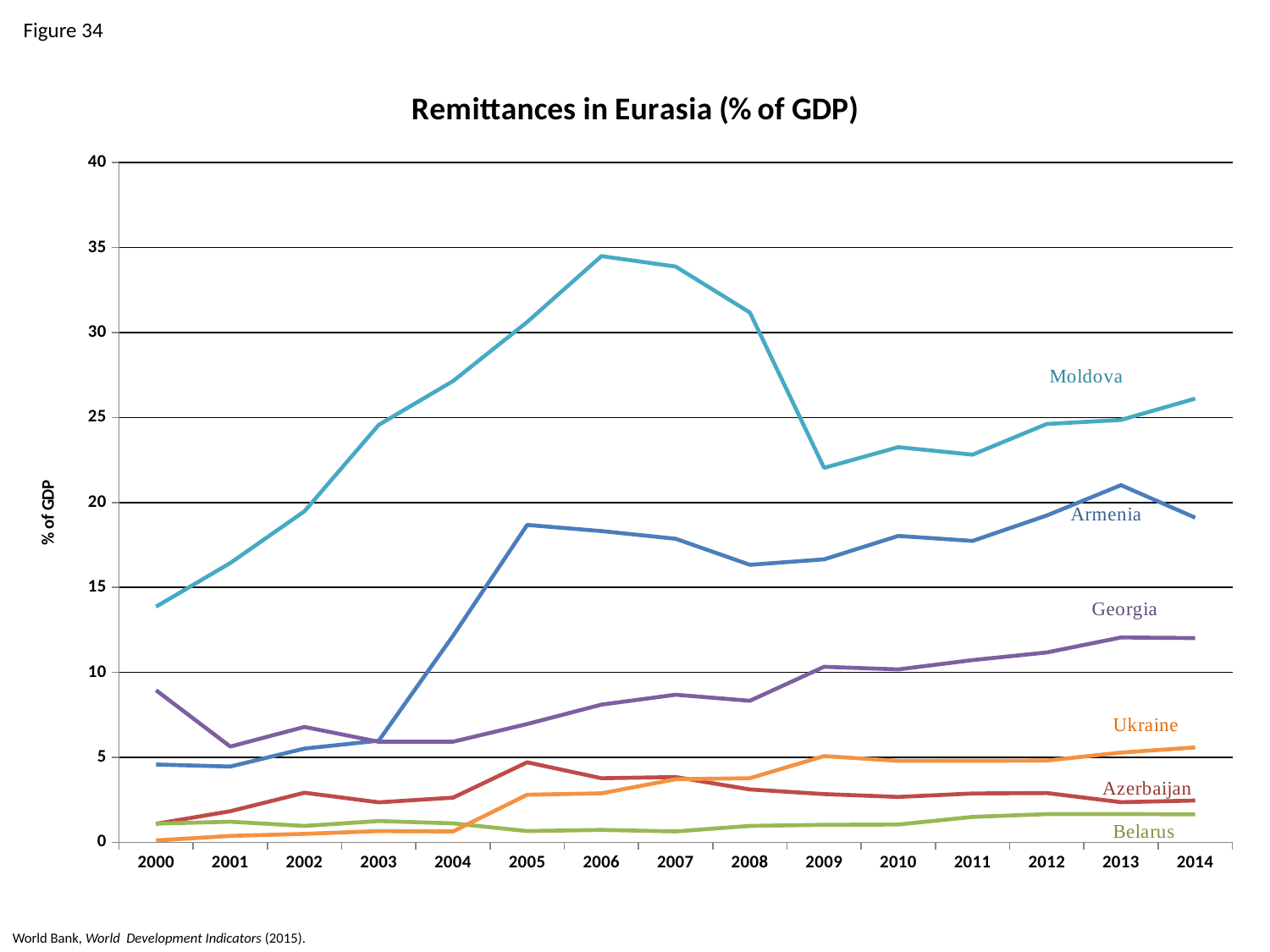
Which country has the highest remittances as % of GDP in 2006? Moldova What is the label on the vertical axis of the chart? % of GDP Is the value for Georgia in 2014 greater or less than 10? greater How many years are shown along the x axis of the chart? 15 Which is larger in 2010, the value for Armenia or the value for Georgia? Armenia Is the value for Moldova in 2006 greater or less than 30? greater Does the value for Moldova rise or fall between 2000 and 2006? rise Which country has the lowest remittances as % of GDP in 2014? Belarus Is the value for Ukraine in 2000 greater or less than 5? less How many countries are plotted as lines on the chart? 6 What is the title of the chart? Remittances in Eurasia (% of GDP) What kind of chart is shown on the slide? line chart